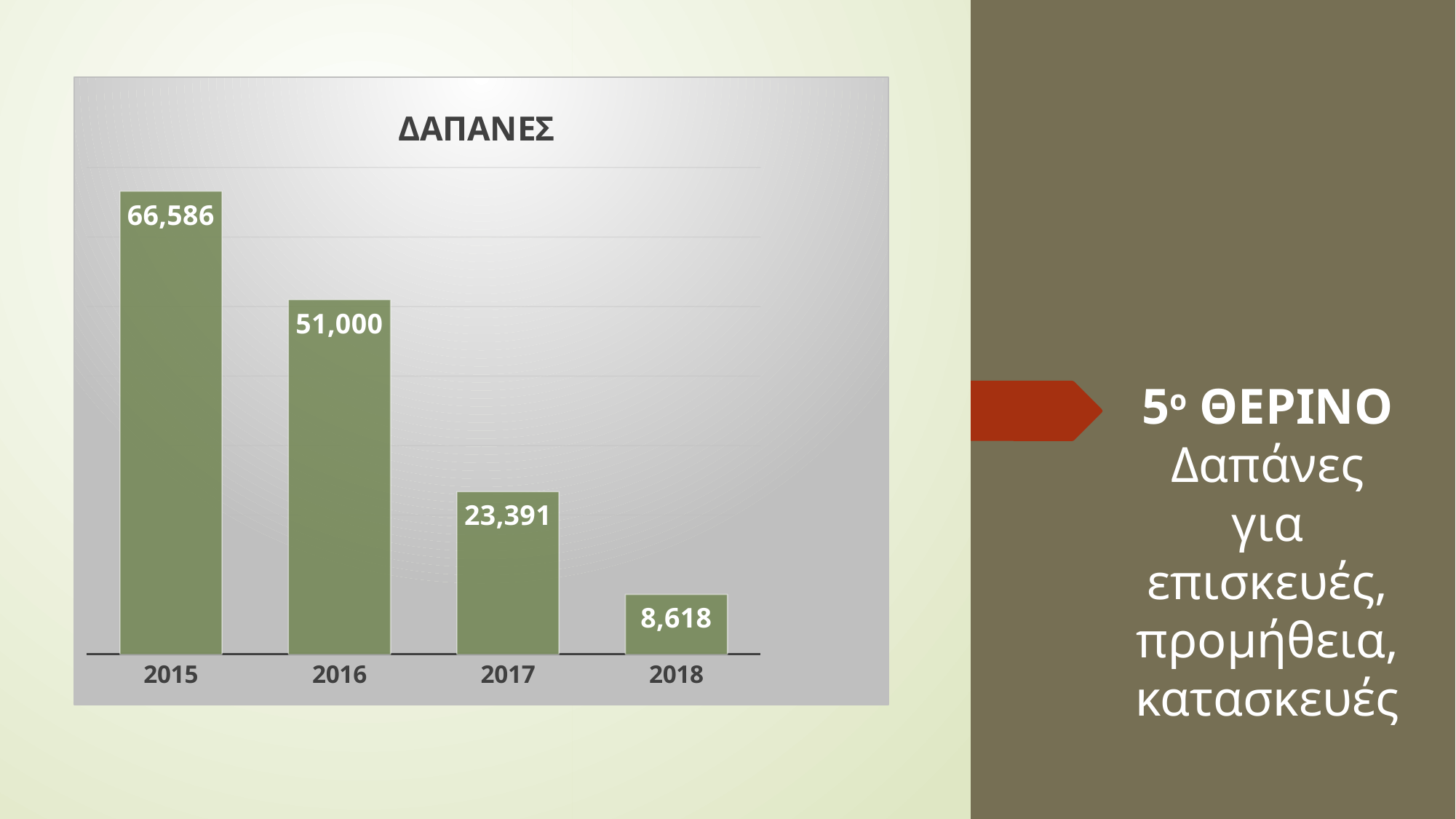
What is the value for 2016? 51,000 What is the value for 2015? 66,586 Which is larger, the value for 2016 or the value for 2017? 2016 What is the value for 2018? 8,618 Which year has the lowest value? 2018 Do the values rise or fall from 2015 to 2018? fall What is the difference between the values for 2015 and 2016? 15,586 What is the difference between the values for 2017 and 2018? 14,773 What kind of chart is shown? bar chart How many years are shown on the x axis? 4 What is the value for 2017? 23,391 Which year has the highest value? 2015